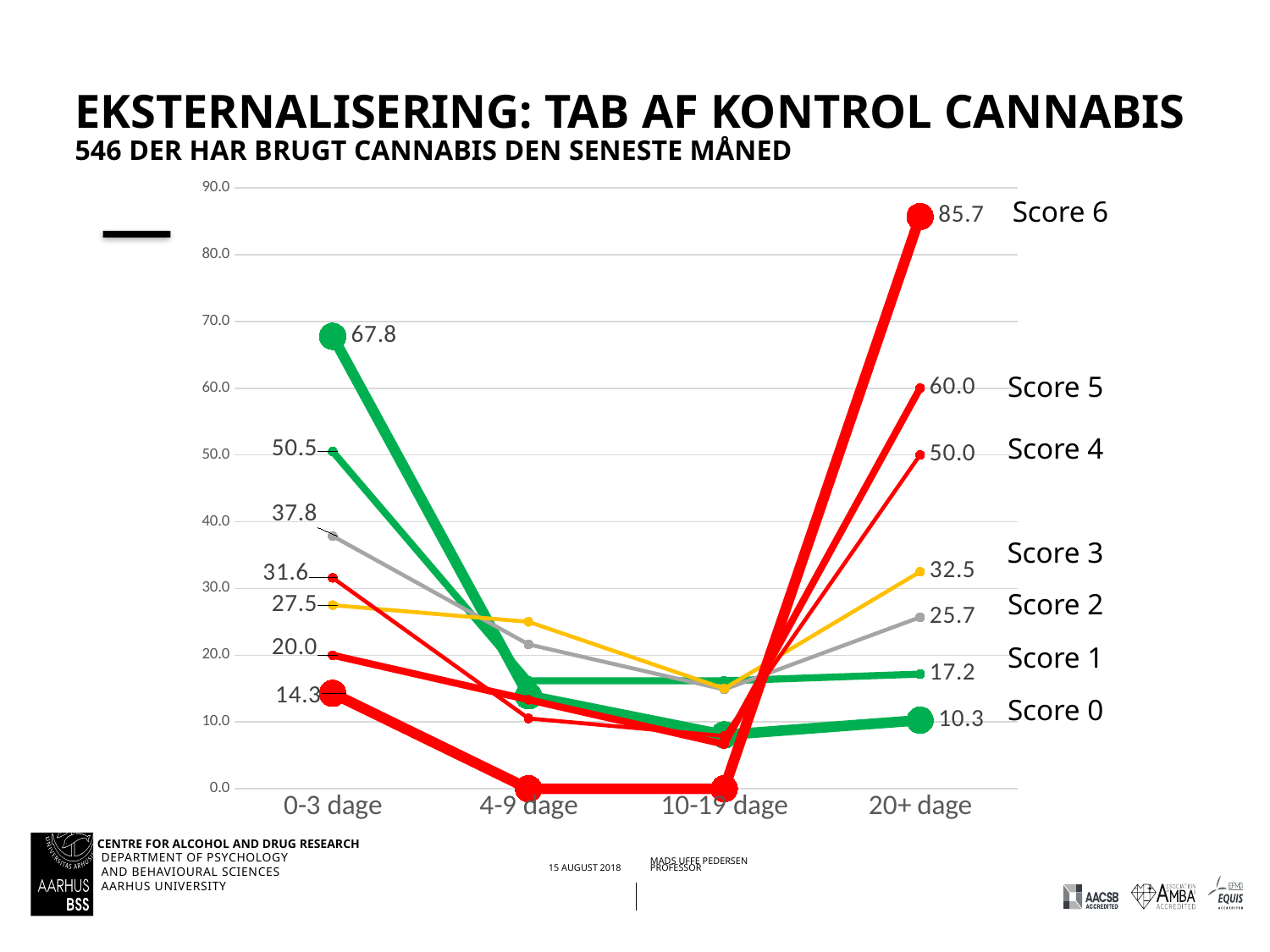
Which score series has the lowest value at 20+ dage? Score 0 How many categories are shown on the x axis? 4 What is the difference between the Score 6 value at 20+ dage (85.7) and at 0-3 dage (14.3)? 71.4 What is the value for Score 3 at 20+ dage? 32.5 What type of chart is shown on the slide? line chart Does the Score 0 line rise or fall from 0-3 dage to 20+ dage? fall What is the value for Score 6 at 20+ dage? 85.7 How many score series are labelled on the chart? 7 What is the value for Score 0 at 0-3 dage? 67.8 At 20+ dage, which is larger: Score 5 or Score 4? Score 5 Which score series has the highest value at 20+ dage? Score 6 Is the value for Score 6 at 4-9 dage greater or less than 10.0? less